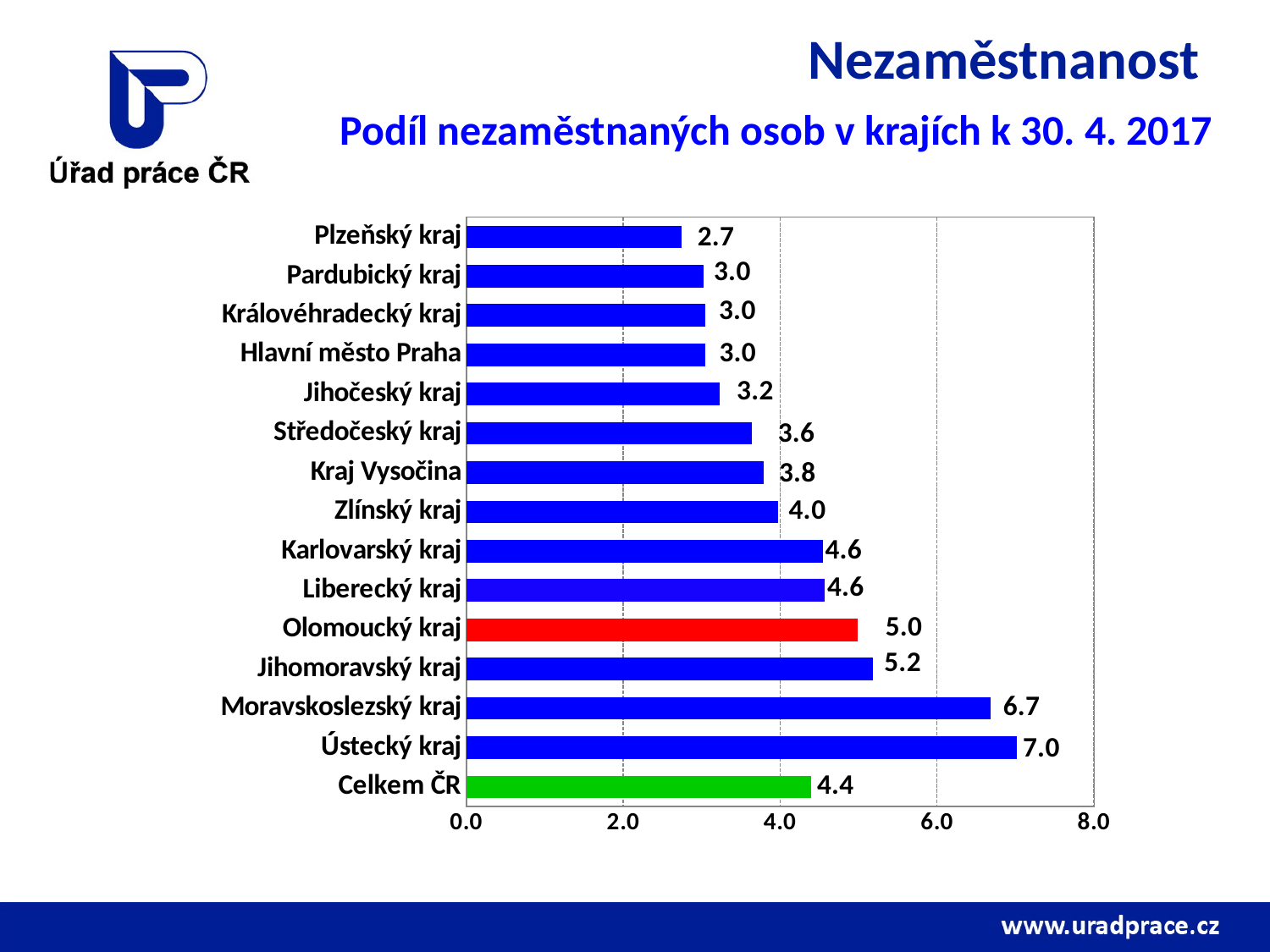
What is the value for Moravskoslezský kraj? 6.7 Which region has the highest value? Ústecký kraj Which is larger, the value for Jihomoravský kraj or the value for Zlínský kraj? Jihomoravský kraj Which bar is coloured red? Olomoucký kraj What kind of chart is shown on the slide? bar chart Is the value for Moravskoslezský kraj greater or less than 6.0? greater How many bars are shown in the chart? 15 Which region has the lowest value? Plzeňský kraj What is the difference between the values for Ústecký kraj and Plzeňský kraj? 4.3 What is the value for Olomoucký kraj? 5.0 What is the title of the chart? Podíl nezaměstnaných osob v krajích k 30. 4. 2017 What is the value for Celkem ČR? 4.4